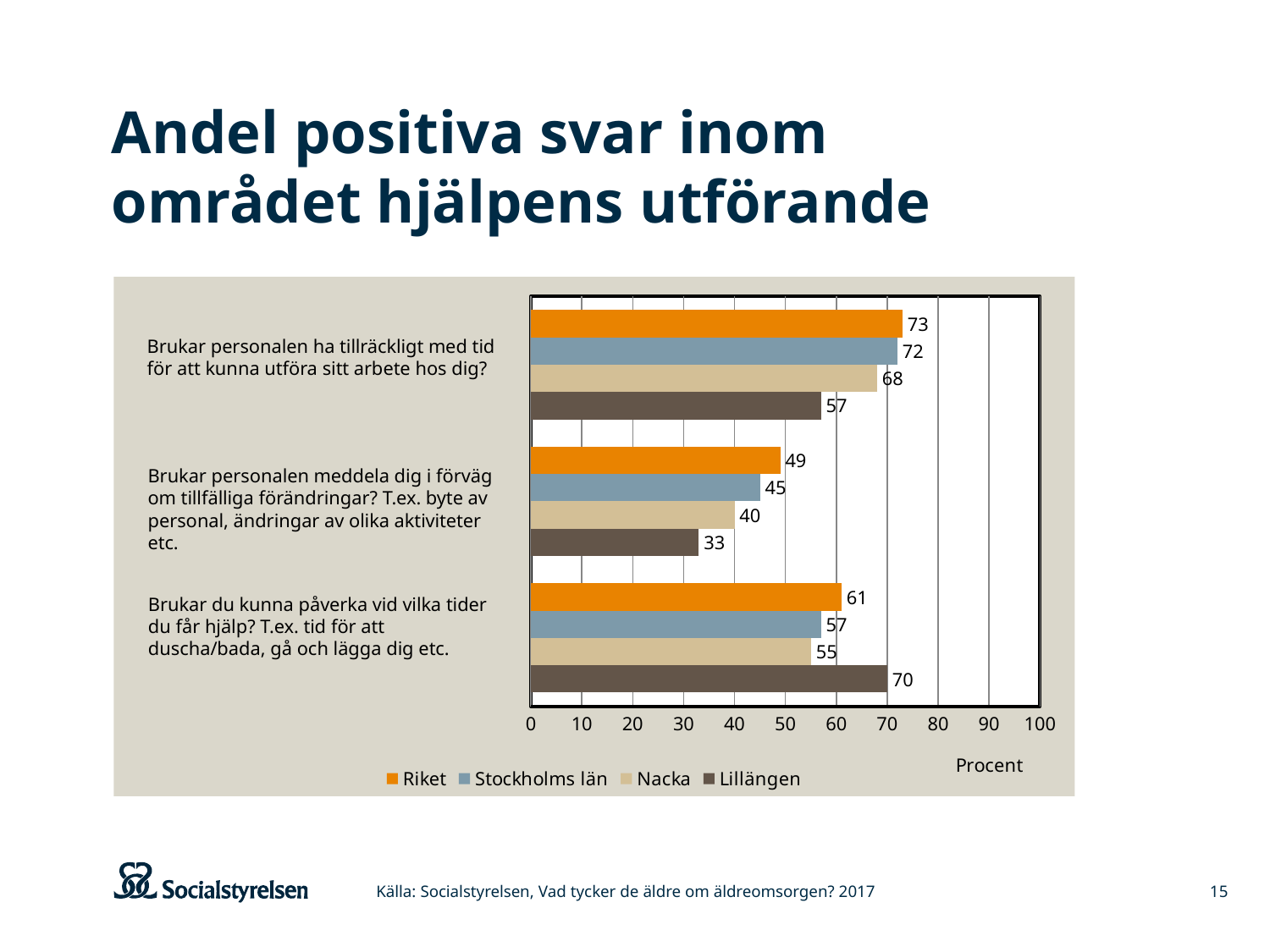
What is the value for Lillängen on the question "Brukar du kunna påverka vid vilka tider du får hjälp?"? 70 What is the value for Stockholms län on the question "Brukar du kunna påverka vid vilka tider du får hjälp?"? 57 What is the value for Nacka on the question "Brukar personalen meddela dig i förväg om tillfälliga förändringar?"? 40 What is the unit label shown on the x axis? Procent How many questions (categories) are shown on the chart? 3 Which series has the highest value on the question "Brukar du kunna påverka vid vilka tider du får hjälp?"? Lillängen Which series has the lowest value on the question "Brukar personalen meddela dig i förväg om tillfälliga förändringar?"? Lillängen What is the value for Riket on the question "Brukar personalen ha tillräckligt med tid för att kunna utföra sitt arbete hos dig?"? 73 What is the difference between Riket and Lillängen on the question "Brukar personalen ha tillräckligt med tid för att kunna utföra sitt arbete hos dig?"? 16 How many series does the legend list? 4 What kind of chart is shown on the slide? Bar chart Which is larger on the question "Brukar personalen meddela dig i förväg om tillfälliga förändringar?": Riket or Stockholms län? Riket